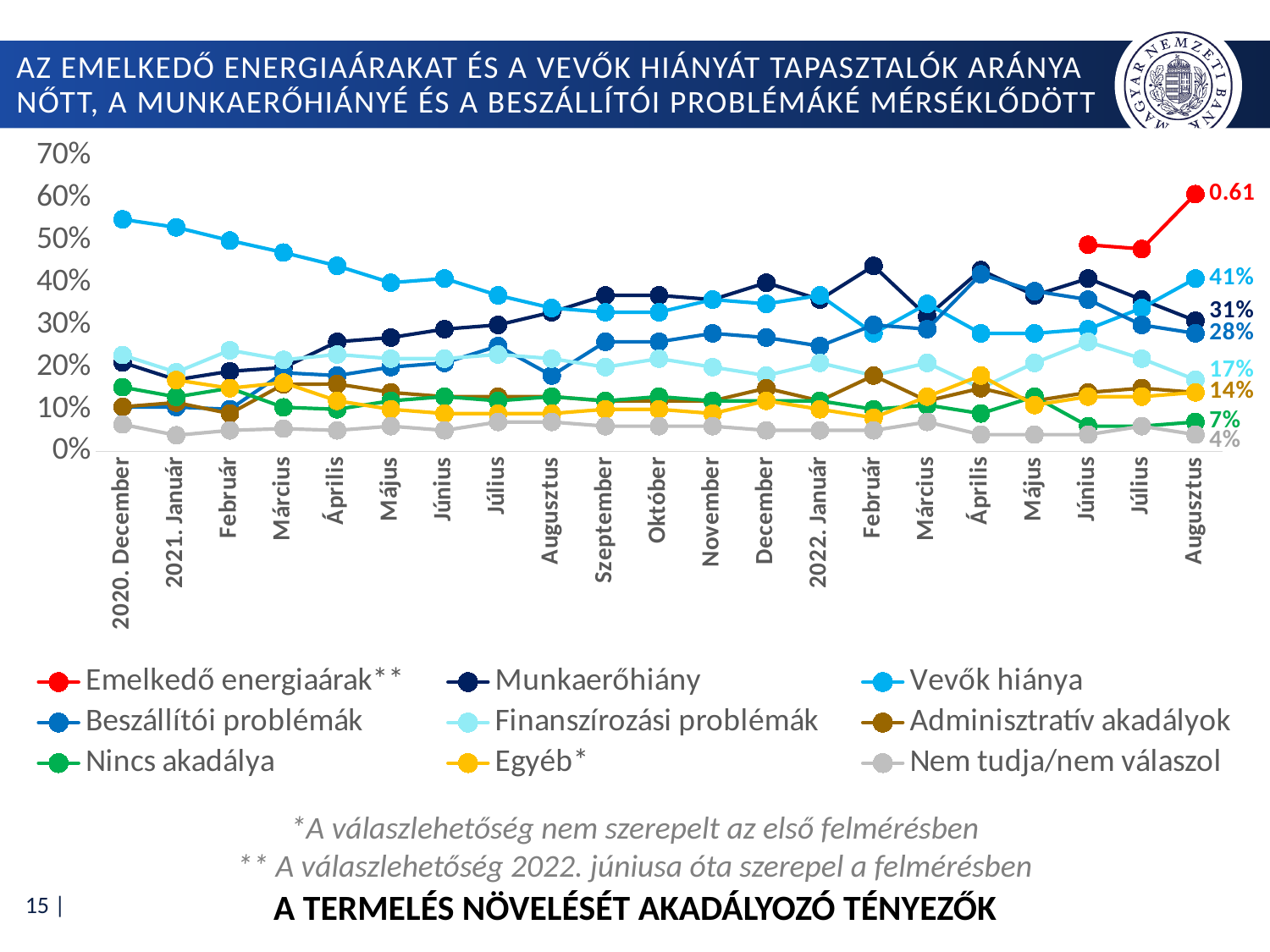
How many time points are shown on the x axis? 21 What is the value for Nem tudja/nem válaszol in Augusztus 2022? 4% What kind of chart is shown on the slide? line chart Which series has the highest value in Augusztus 2022? Emelkedő energiaárak What is the data label shown for Emelkedő energiaárak at the last point (Augusztus 2022)? 0.61 Does the Vevők hiánya series rise or fall from 2020. December to Augusztus 2021? fall Which series has the lowest value in Augusztus 2022? Nem tudja/nem válaszol What is the value for Vevők hiánya in Augusztus 2022? 41% What is the value for Munkaerőhiány in Augusztus 2022? 31% How many series does the legend list? 9 Is the value for Vevők hiánya in 2020. December greater or less than 50%? greater What is the difference between Vevők hiánya and Beszállítói problémák in Augusztus 2022? 13 percentage points